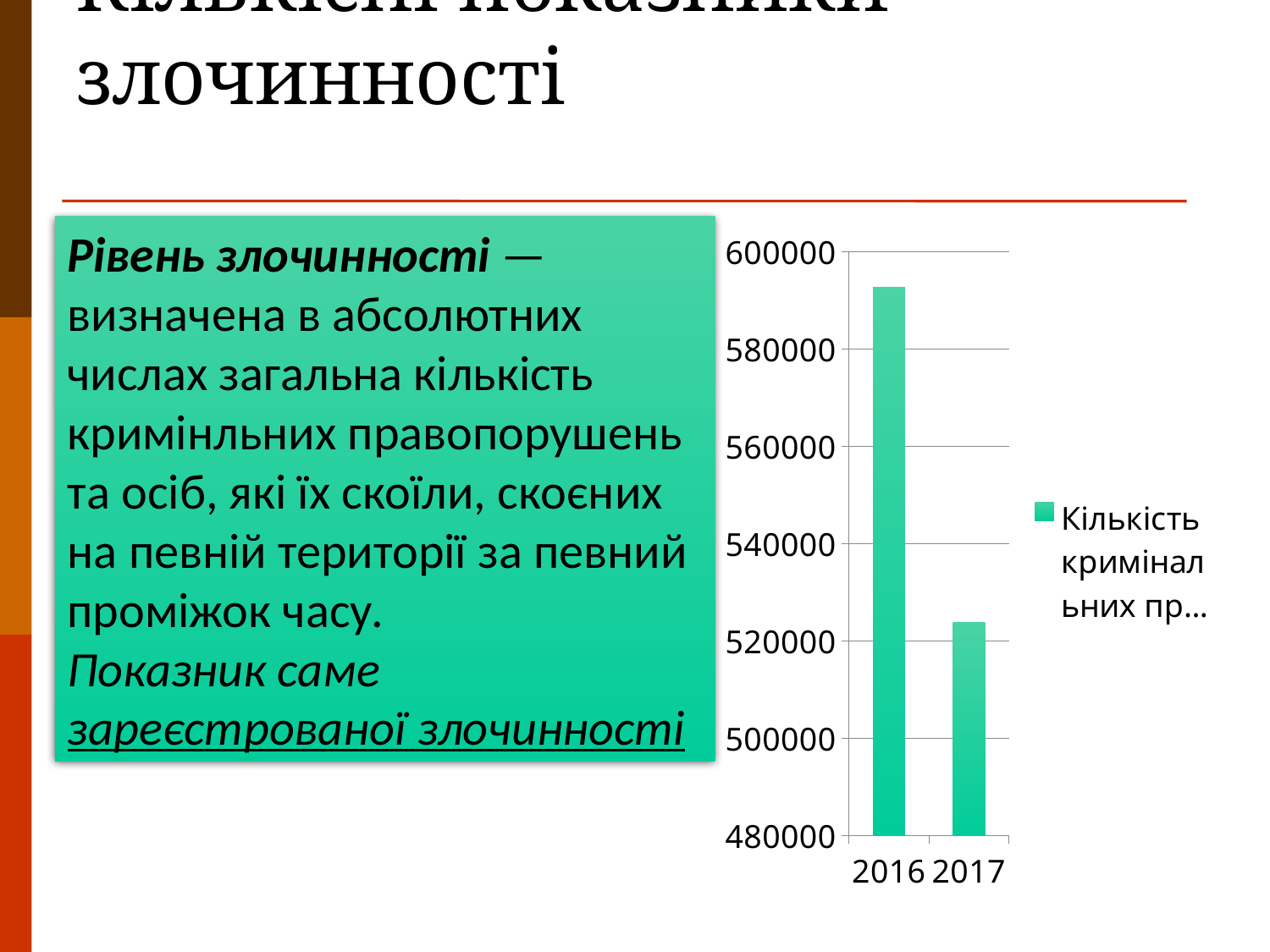
Which is larger, the value for 2016 or the value for 2017? 2016 How many categories (years) are plotted on the x axis of the chart? 2 Which year has the highest bar in the chart? 2016 What is the lowest value shown on the chart's vertical axis? 480000 Is the value for 2017 greater or less than 540000? less What kind of chart is shown on the slide? bar chart Is the value for 2016 greater or less than 600000? less Which year has the lowest bar in the chart? 2017 How many series does the chart's legend list? 1 Do the values rise or fall from 2016 to 2017? fall What colour are the bars in the chart? green Is the value for 2016 greater or less than 580000? greater